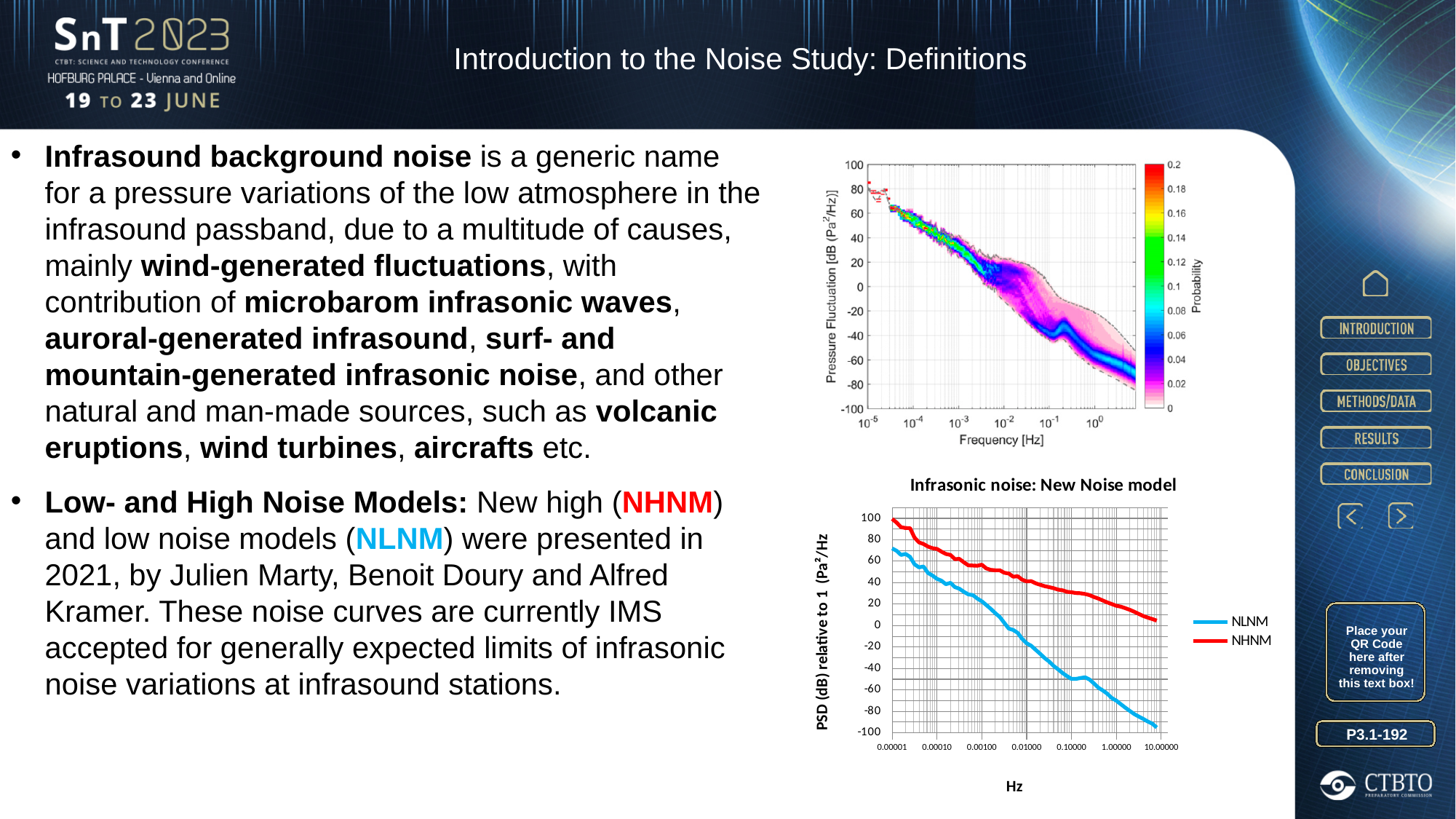
In the chart titled "Infrasonic noise: New Noise model", what are the names of the two series in the legend? NLNM and NHNM In the chart titled "Infrasonic noise: New Noise model", do the NLNM values rise or fall as frequency increases along the x axis? fall In the chart titled "Infrasonic noise: New Noise model", is the NHNM value at 10 Hz greater or less than 20? less In the top chart on the right of the slide, what is the maximum value shown on the Probability colour bar? 0.2 In the chart titled "Infrasonic noise: New Noise model", how many series does the legend list? 2 In the chart titled "Infrasonic noise: New Noise model", is the NLNM value at 10 Hz greater or less than -80? less In the chart titled "Infrasonic noise: New Noise model", what kind of chart is it? line chart In the chart titled "Infrasonic noise: New Noise model", which series is drawn in red? NHNM In the chart titled "Infrasonic noise: New Noise model", is the NHNM value at 0.00001 Hz greater or less than 80? greater In the chart titled "Infrasonic noise: New Noise model", do the NHNM values rise or fall as frequency increases along the x axis? fall In the chart titled "Infrasonic noise: New Noise model", which series has the higher value at 0.01 Hz, NLNM or NHNM? NHNM